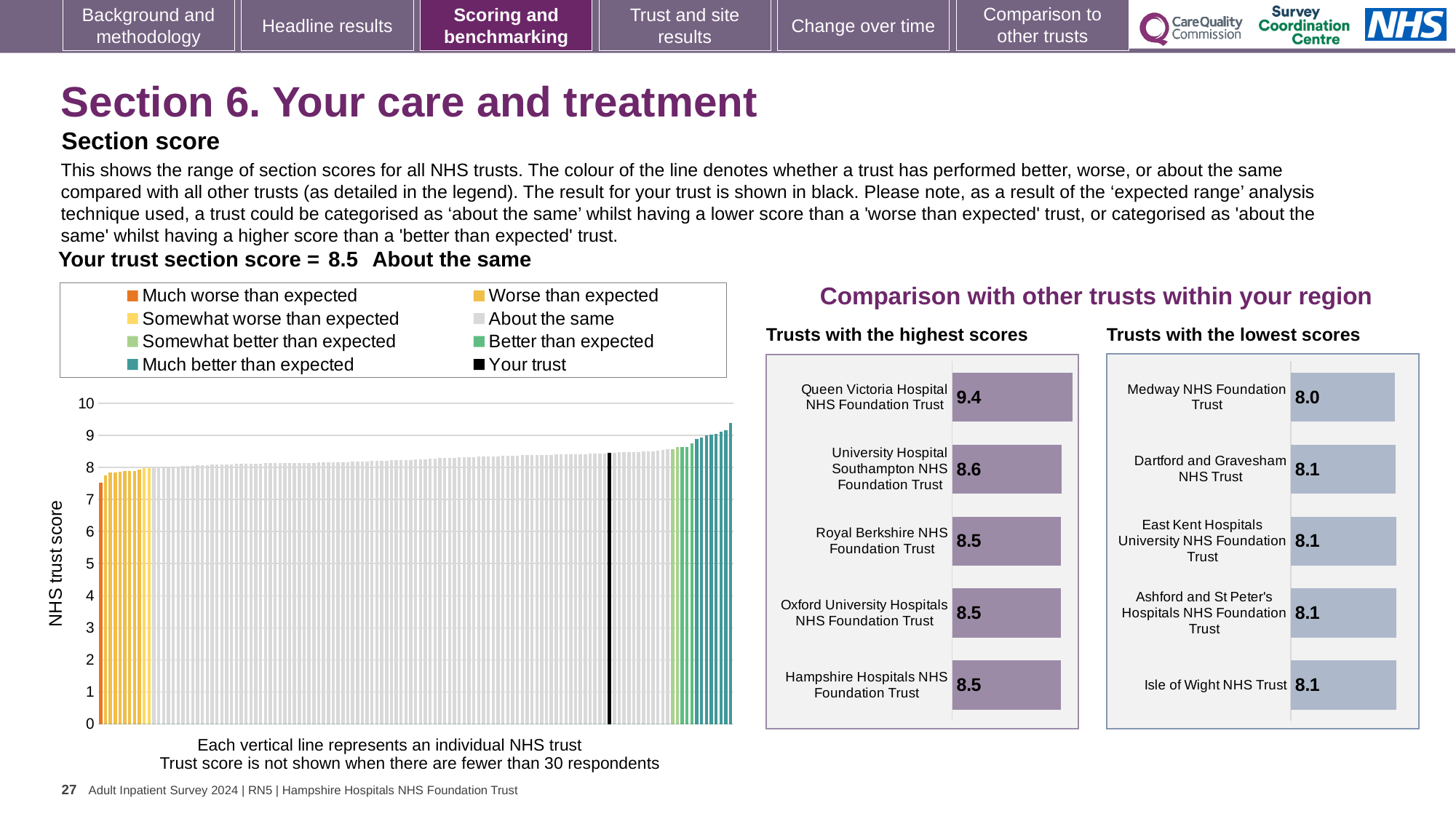
In the large chart on the left, what colour is used for the bar representing your trust? Black In the 'Trusts with the highest scores' chart, which has the larger score: University Hospital Southampton NHS Foundation Trust or Royal Berkshire NHS Foundation Trust? University Hospital Southampton NHS Foundation Trust According to the slide, what is your trust's section score for Section 6? 8.5 In the large chart on the left, do the NHS trust scores rise or fall from left to right? Rise In the 'Trusts with the highest scores' chart, what is the score for Queen Victoria Hospital NHS Foundation Trust? 9.4 In the 'Trusts with the highest scores' chart, which trust has the highest score? Queen Victoria Hospital NHS Foundation Trust What kind of chart is the large chart on the left showing NHS trust scores? Bar chart How many trusts are shown in the 'Trusts with the highest scores' chart? 5 In the 'Trusts with the highest scores' chart, what is the difference between the scores of Queen Victoria Hospital NHS Foundation Trust and Hampshire Hospitals NHS Foundation Trust? 0.9 How many entries does the legend of the large chart on the left list? 8 In the 'Trusts with the lowest scores' chart, which trust has the lowest score? Medway NHS Foundation Trust In the 'Trusts with the lowest scores' chart, what is the score for Medway NHS Foundation Trust? 8.0